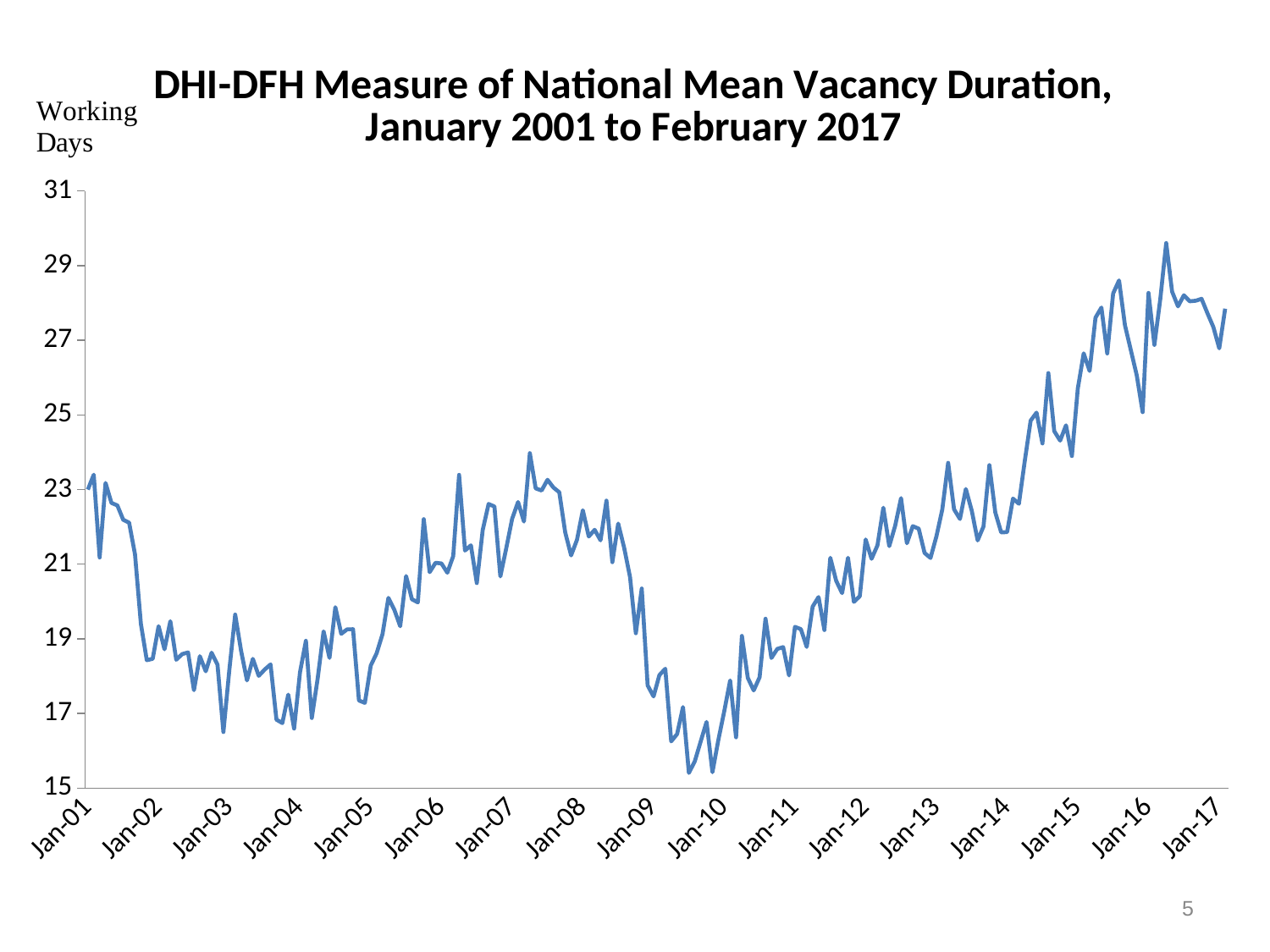
What unit is the vertical axis labelled with? Working Days Is the lowest point of the line, reached between Jan-09 and Jan-10, greater or less than 17? less In which year does the line reach its highest point? 2016 What is the title of the chart? DHI-DFH Measure of National Mean Vacancy Duration, January 2001 to February 2017 In which year does the line reach its lowest point? 2009 Does the line rise or fall between Jan-08 and Jan-10? fall What kind of chart is shown on the slide? line chart Is the value at Jan-01 greater or less than 21? greater Is the value at Jan-16 greater or less than 27? greater Does the line rise or fall between Jan-10 and Jan-16? rise